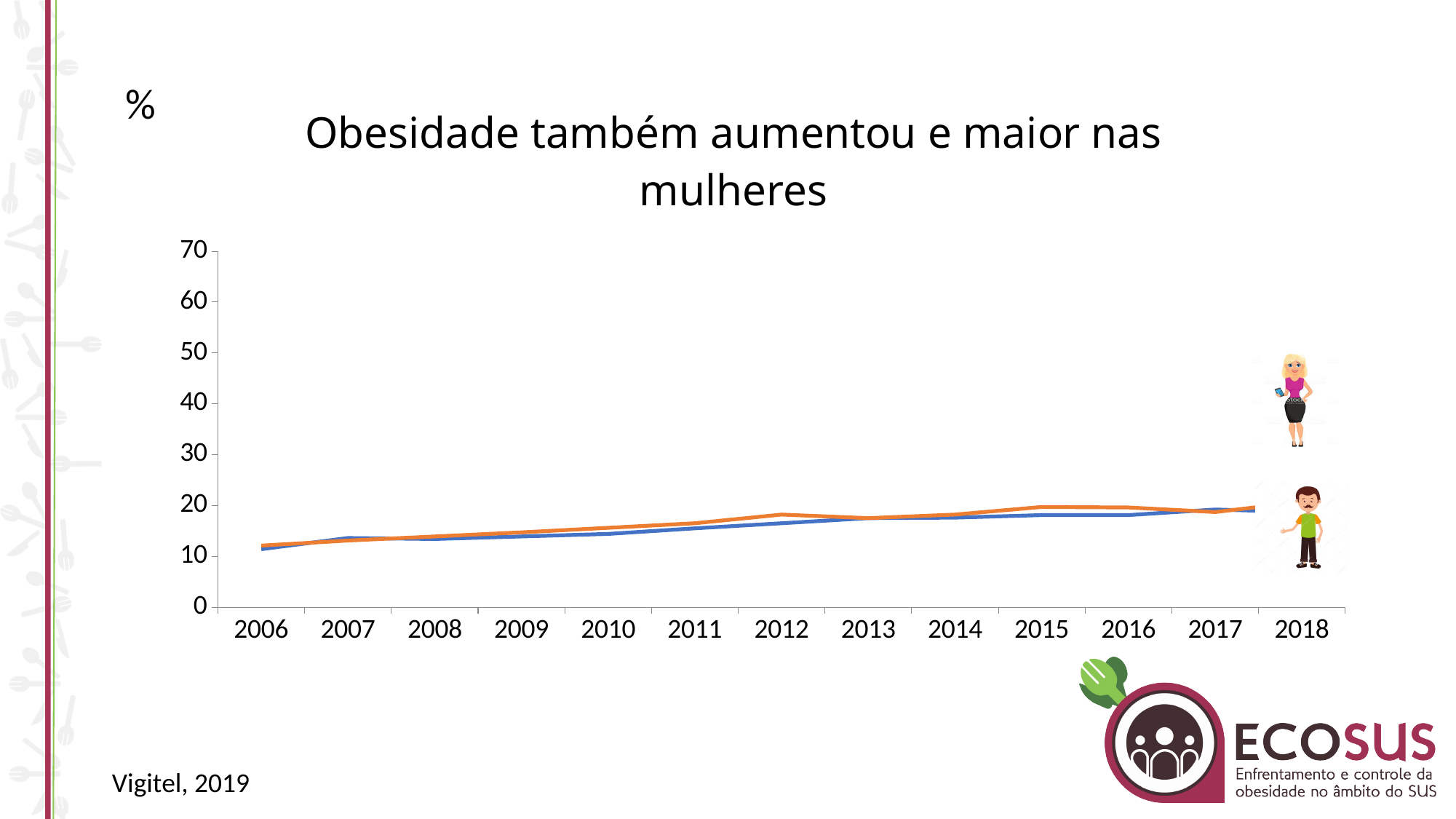
Is the value of the orange line in 2018 greater or less than 10? greater Is the value of the orange line in 2018 greater or less than 30? less Is the value of the blue line in 2010 greater or less than 20? less Do the values on the chart generally rise or fall from 2006 to 2018? rise In 2012, which line is higher, the orange line or the blue line? orange What kind of chart is shown on the slide? line chart What is the title of the chart? Obesidade também aumentou e maior nas mulheres How many years are shown on the x axis of the chart? 13 What is the highest value shown on the y axis of the chart? 70 In which year is the orange line at its lowest value? 2006 How many lines are plotted on the chart? 2